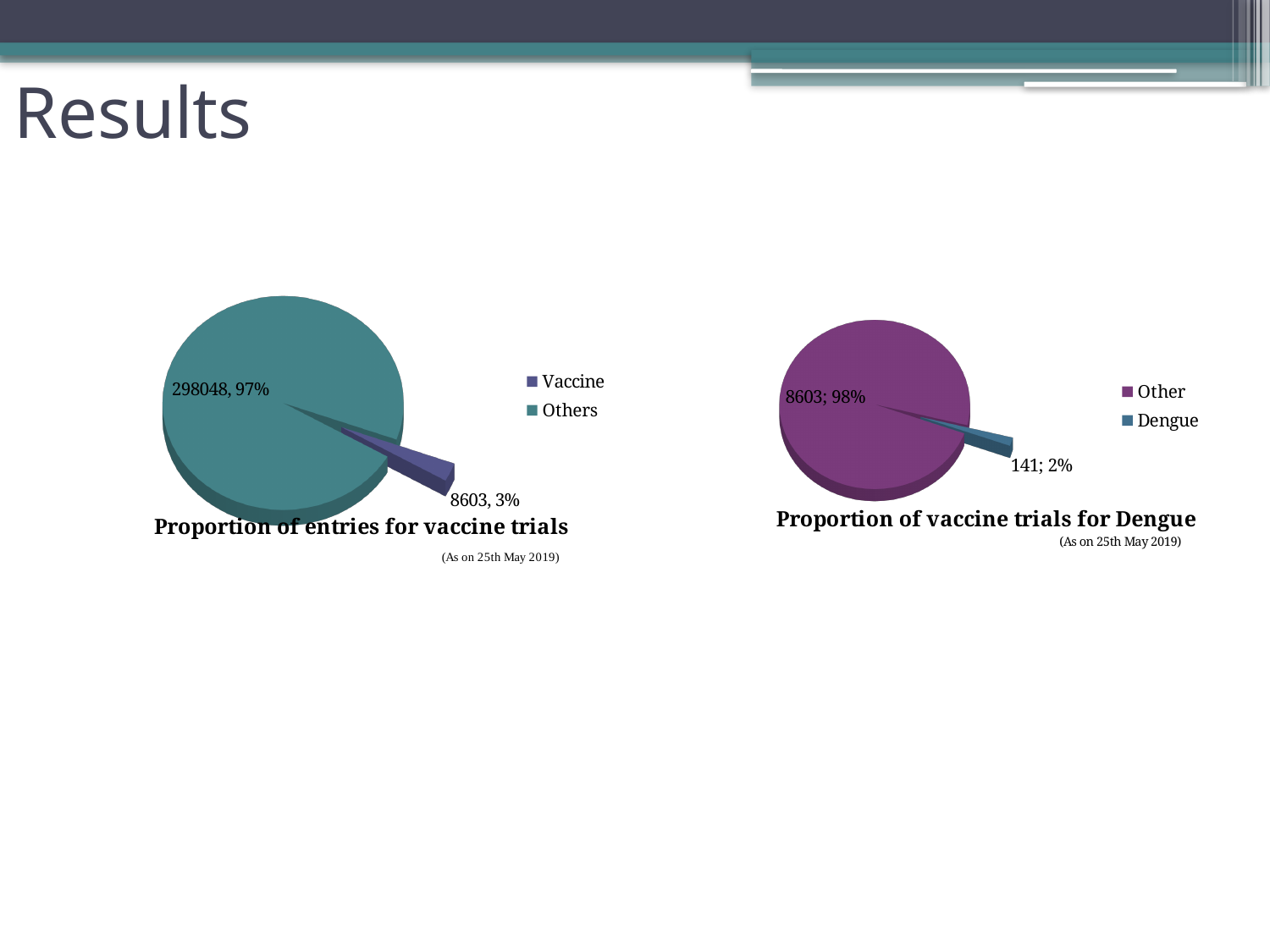
How many categories does the legend of the 'Proportion of vaccine trials for Dengue' chart list? 2 In the 'Proportion of vaccine trials for Dengue' chart, which category is the smallest? Dengue What kind of chart is the chart on the left of the slide? pie chart In the 'Proportion of vaccine trials for Dengue' chart, what share of the pie does Other represent? 98% In the 'Proportion of entries for vaccine trials' chart, what value is shown for Others? 298048 In the 'Proportion of entries for vaccine trials' chart, what share of the pie does Vaccine represent? 3% In the 'Proportion of vaccine trials for Dengue' chart, is the value for Other larger or smaller than the value for Dengue? larger In the 'Proportion of entries for vaccine trials' chart, which category is the largest? Others What date is given beneath the title of the 'Proportion of entries for vaccine trials' chart? As on 25th May 2019 In the 'Proportion of entries for vaccine trials' chart, what is the difference between the Others value and the Vaccine value? 289445 In the 'Proportion of vaccine trials for Dengue' chart, what value is shown for Dengue? 141 In the 'Proportion of entries for vaccine trials' chart, what value is shown for Vaccine? 8603